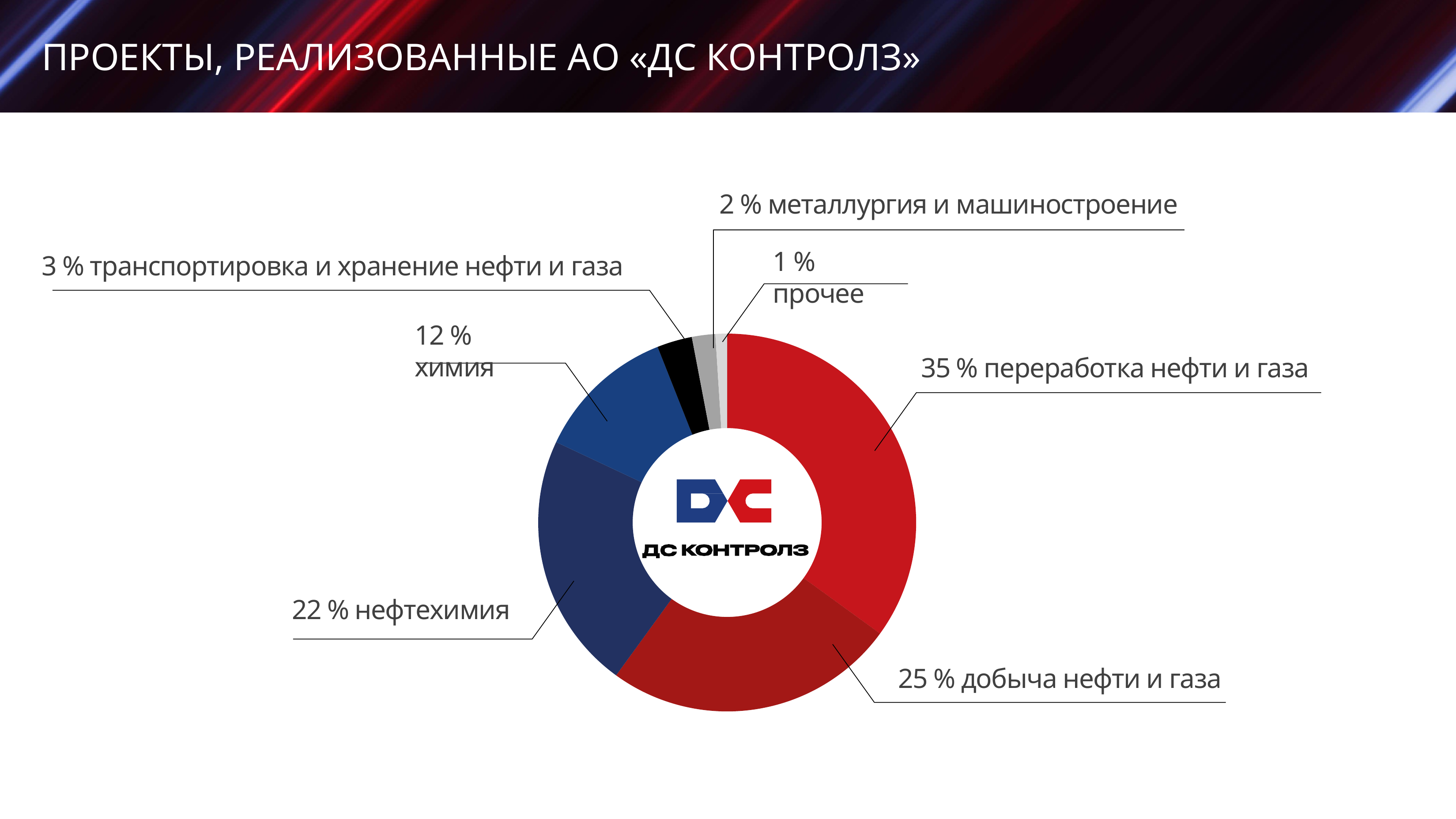
What share of projects is for химия? 12 % What is the difference in percentage points between переработка нефти и газа and добыча нефти и газа? 10 What share of projects is for переработка нефти и газа? 35 % How many sectors are shown in the chart? 7 Which sector has the largest share of projects? переработка нефти и газа What is the title of the slide? ПРОЕКТЫ, РЕАЛИЗОВАННЫЕ АО «ДС КОНТРОЛЗ» What kind of chart is shown on the slide? doughnut chart What share of projects is for нефтехимия? 22 % Which has a larger share: нефтехимия or химия? нефтехимия Which sector has the smallest share of projects? прочее What share of projects is for транспортировка и хранение нефти и газа? 3 % What is the combined share of добыча нефти и газа and нефтехимия? 47 %